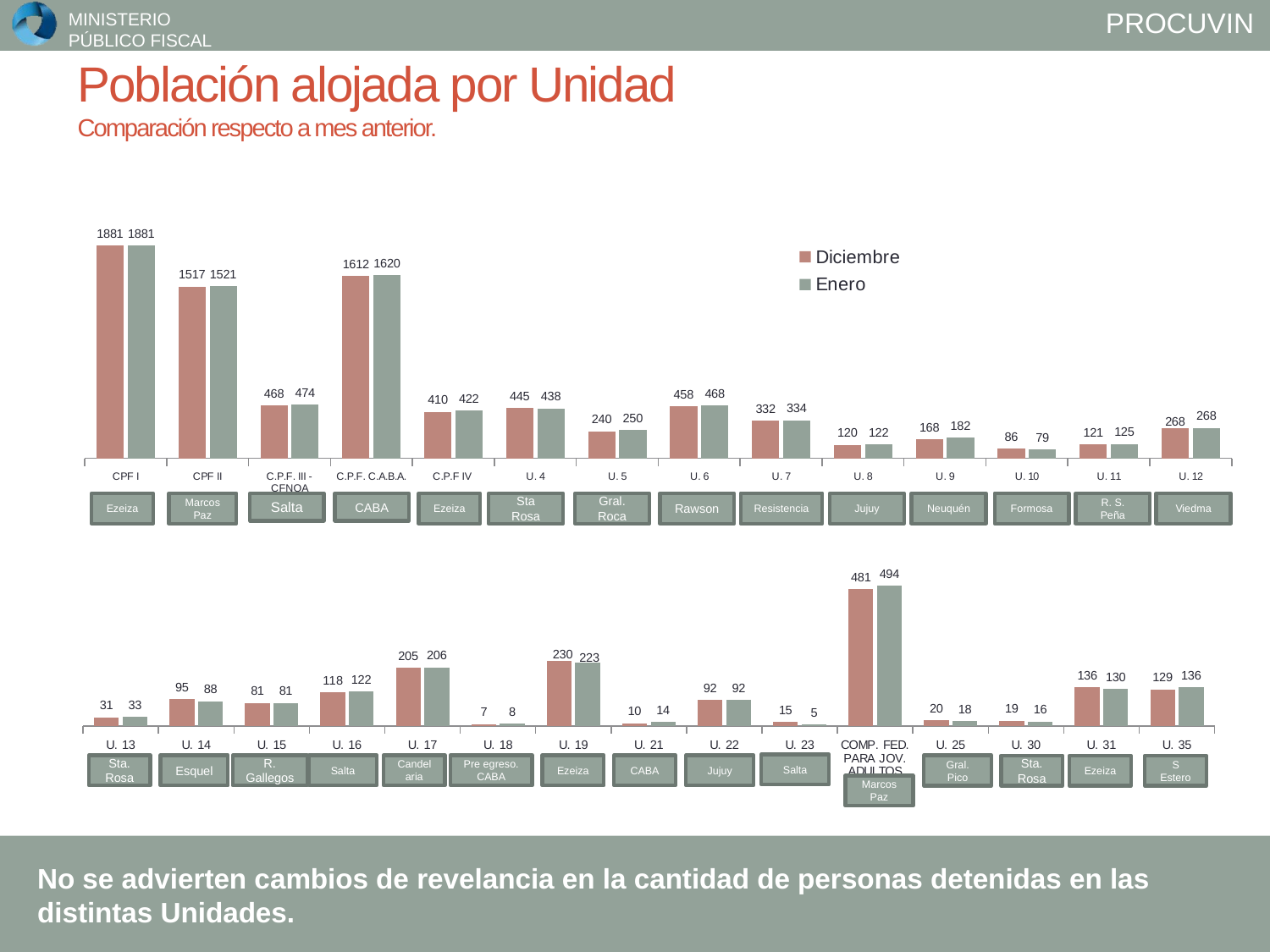
In the top chart, what is the difference between the Enero and Diciembre values for C.P.F. C.A.B.A.? 8 How many series does the legend list? 2 In the top chart, what is the Diciembre value for U. 9? 168 In the top chart, which is larger for U. 10: the Diciembre value or the Enero value? Diciembre In the bottom chart, what is the Diciembre value for COMP. FED. PARA JOV. ADULTOS? 481 In the bottom chart, which unit has the lowest Enero value? U. 23 How many units are shown in the bottom chart? 15 In the bottom chart, what is the Enero value for U. 19? 223 In the bottom chart, what is the difference between the Diciembre and Enero values for U. 23? 10 In the top chart, what is the Enero value for CPF II? 1521 In the top chart, which unit has the highest Enero value? CPF I What type of chart is used on this slide? Bar chart